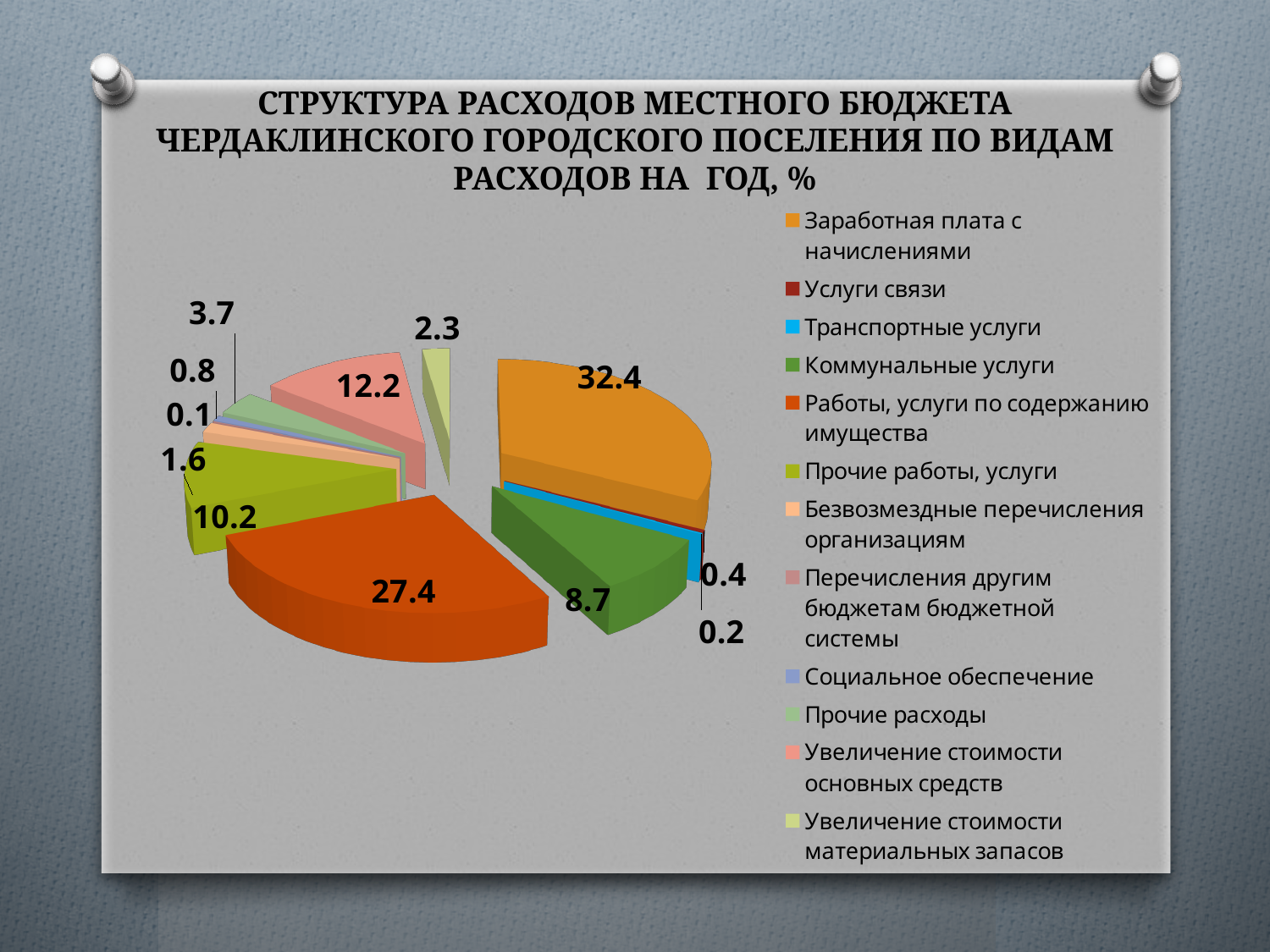
What is the value for Прочие работы, услуги? 10.2 What is the value for Увеличение стоимости материальных запасов? 2.3 What is the value for Заработная плата с начислениями? 32.4 What colour is the slice for Заработная плата с начислениями? Orange What type of chart is shown on the slide? Pie chart What is the smallest value labelled on the pie chart? 0.1 What is the value for Коммунальные услуги? 8.7 Which category has the largest share of the pie? Заработная плата с начислениями How many categories does the legend list? 12 What is the value for Работы, услуги по содержанию имущества? 27.4 Which is larger: Коммунальные услуги or Прочие работы, услуги? Прочие работы, услуги What is the difference between the values for Заработная плата с начислениями and Работы, услуги по содержанию имущества? 5.0